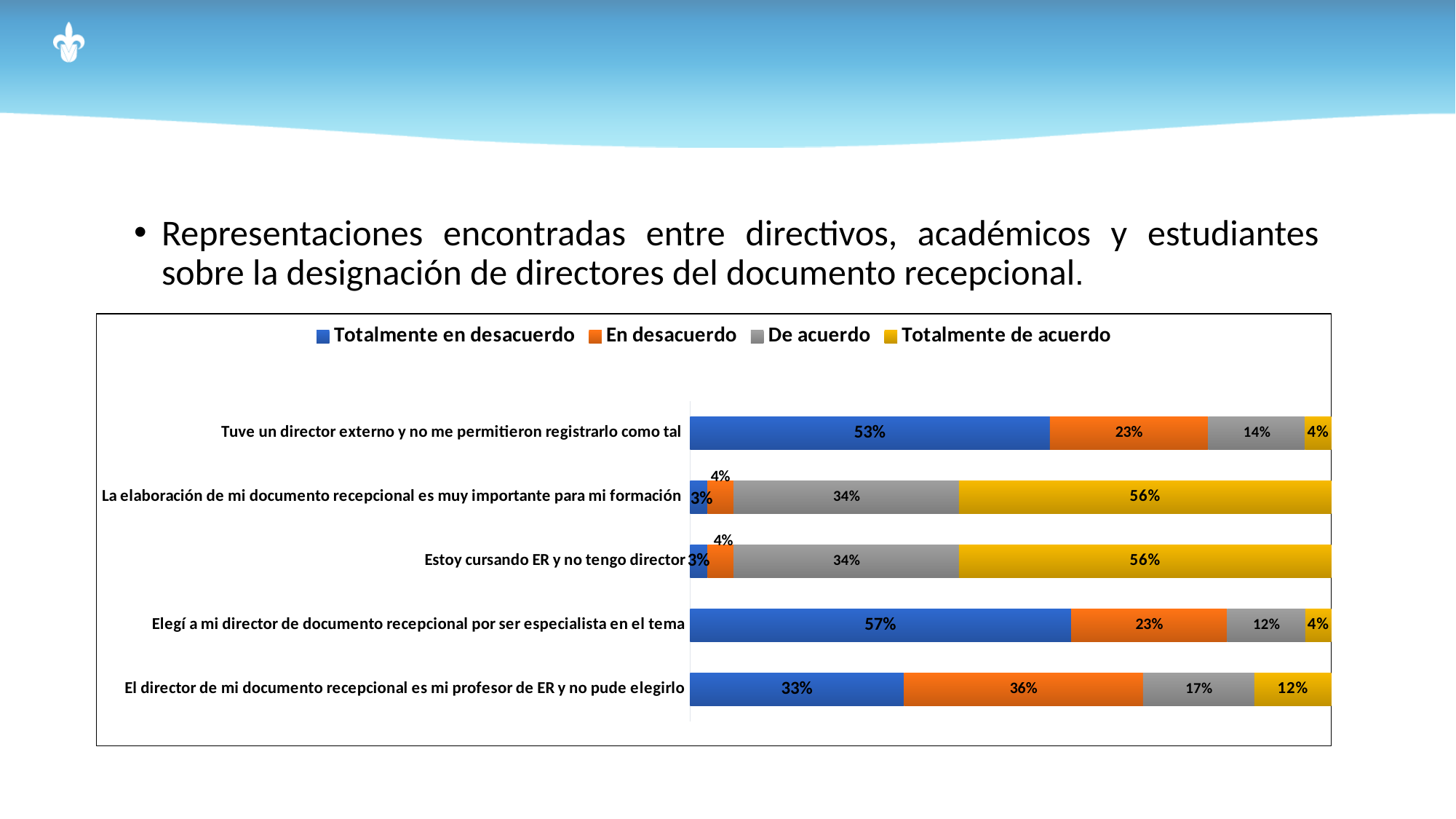
Which category has the lowest value for "De acuerdo"? Elegí a mi director de documento recepcional por ser especialista en el tema How many categories (statements) are shown in the chart? 5 What is the difference in "Totalmente en desacuerdo" between "Elegí a mi director de documento recepcional por ser especialista en el tema" and "Tuve un director externo y no me permitieron registrarlo como tal"? 4 percentage points Which has a larger "En desacuerdo" value: "El director de mi documento recepcional es mi profesor de ER y no pude elegirlo" or "Tuve un director externo y no me permitieron registrarlo como tal"? El director de mi documento recepcional es mi profesor de ER y no pude elegirlo What is the value for "De acuerdo" for the category "Tuve un director externo y no me permitieron registrarlo como tal"? 14% What colour represents "Totalmente de acuerdo" in the chart? Yellow What is the value for "Totalmente en desacuerdo" for the category "Elegí a mi director de documento recepcional por ser especialista en el tema"? 57% What is the value for "Totalmente de acuerdo" for the category "La elaboración de mi documento recepcional es muy importante para mi formación"? 56% What kind of chart is shown on the slide? Stacked bar chart Which category has the highest value for "Totalmente en desacuerdo"? Elegí a mi director de documento recepcional por ser especialista en el tema What is the value for "En desacuerdo" for the category "El director de mi documento recepcional es mi profesor de ER y no pude elegirlo"? 36% How many series does the legend list? 4